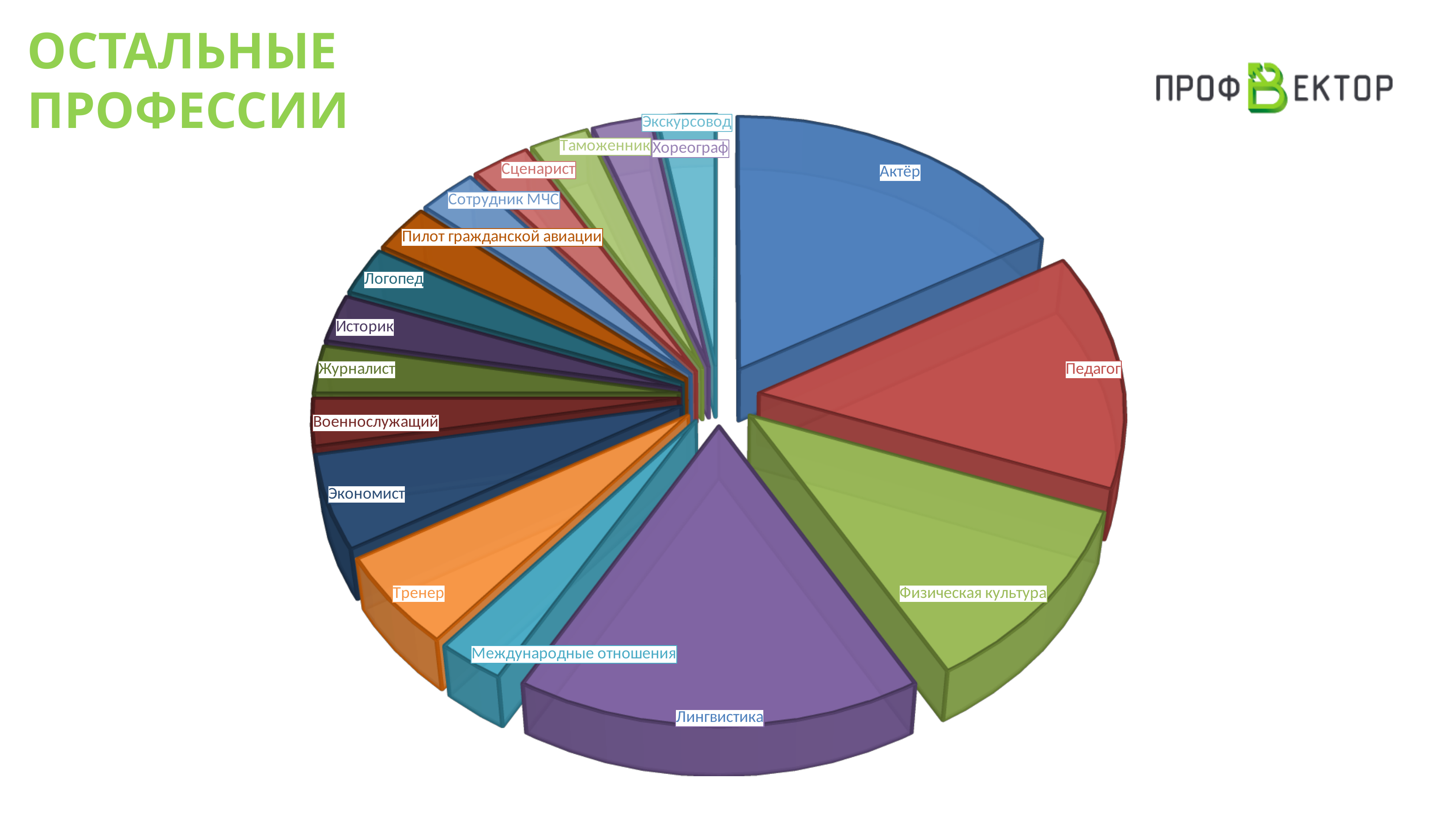
Which slice is larger, Лингвистика or Международные отношения? Лингвистика What kind of chart is shown on the slide? pie chart Which slice is larger, Педагог or Экскурсовод? Педагог What colour is the Лингвистика slice? purple What is the title of the slide with the pie chart? ОСТАЛЬНЫЕ ПРОФЕССИИ Which slice is larger, Экономист or Хореограф? Экономист